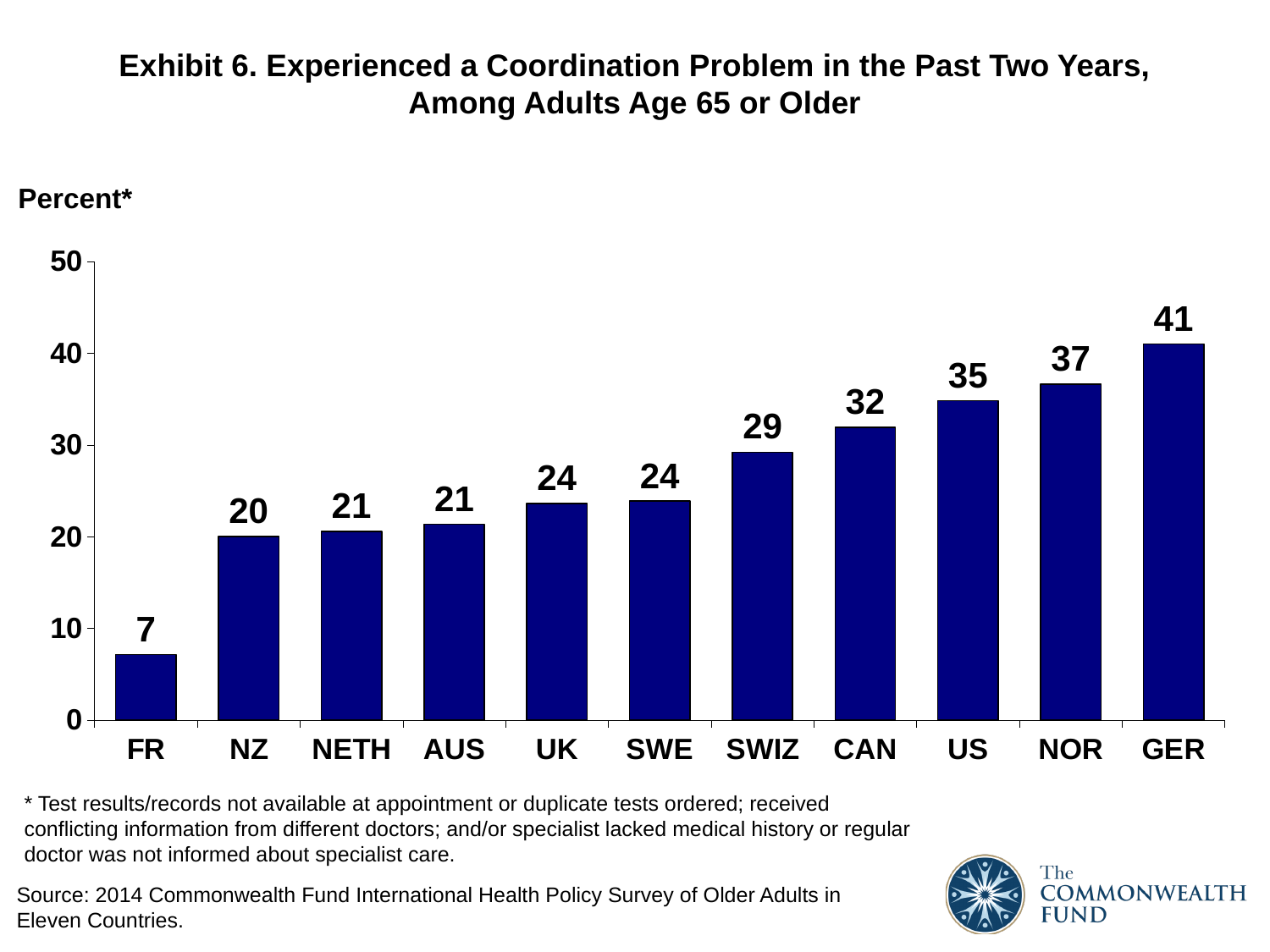
Which is larger, the value for NOR or the value for SWE? NOR How many countries are shown on the chart? 11 Do the values rise or fall from left to right along the x axis? Rise What kind of chart is shown on the slide? Bar chart What is the difference between the values for GER and FR? 34 Which country has the lowest value? FR What is the value for GER? 41 What is the difference between the values for US and CAN? 3 What is the value for SWIZ? 29 Is the value for CAN greater or less than 30? greater Which country has the highest value? GER What is the value for FR? 7